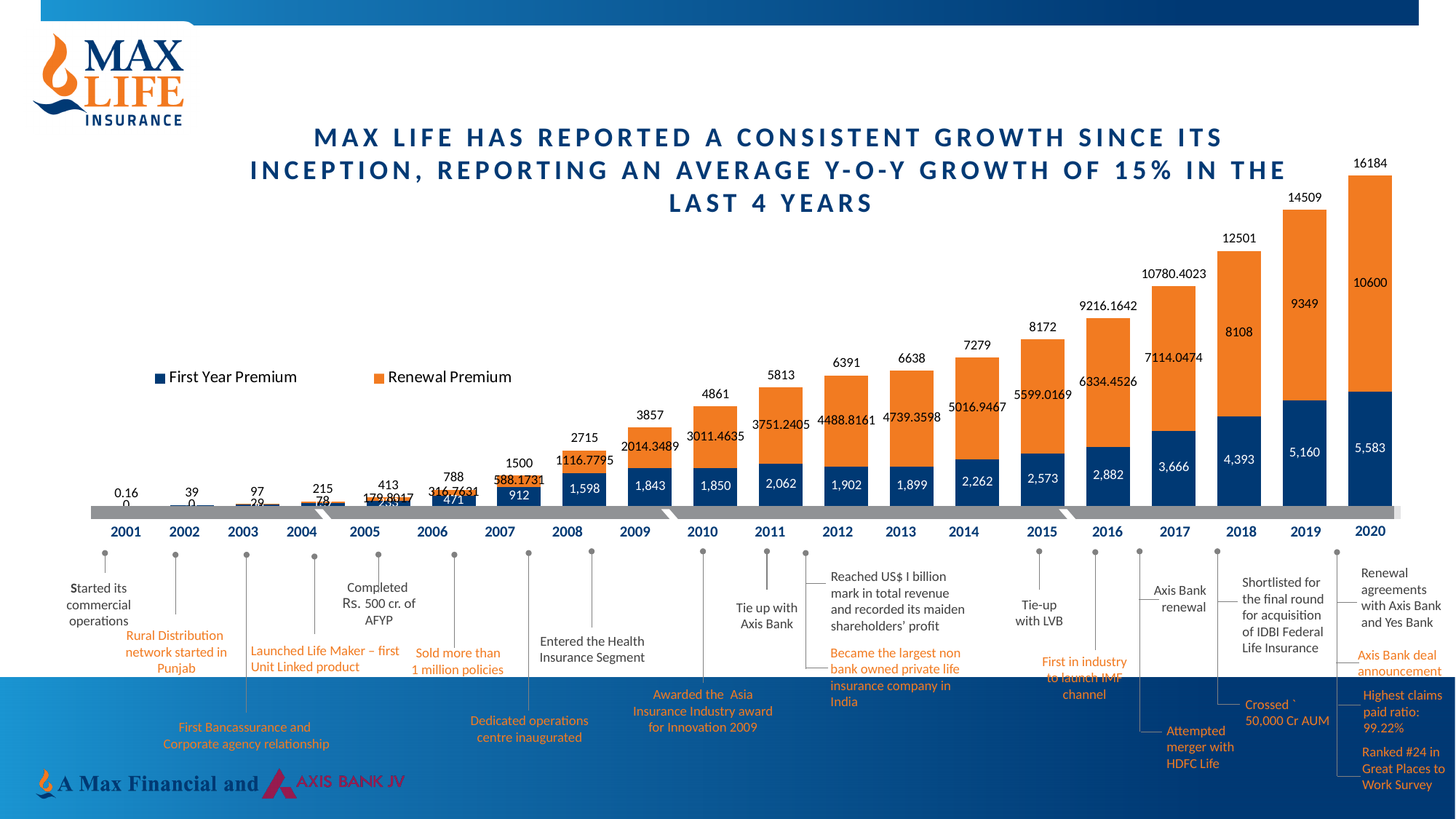
What is the Renewal Premium value for 2017? 7114.0474 What total is labelled above the 2018 bar? 12501 By how much did First Year Premium increase from 2019 to 2020? 423 What is the Renewal Premium value for 2019? 9349 What is the First Year Premium value for 2020? 5,583 What kind of chart is shown on the slide? Stacked bar chart Do the total premium values rise or fall from 2001 to 2020? Rise How many years are shown on the x axis of the chart? 20 What is the difference between the total labelled for 2020 and the total labelled for 2019? 1675 Which year has the highest total premium? 2020 In 2017, which is larger: First Year Premium or Renewal Premium? Renewal Premium How many series does the legend list? 2